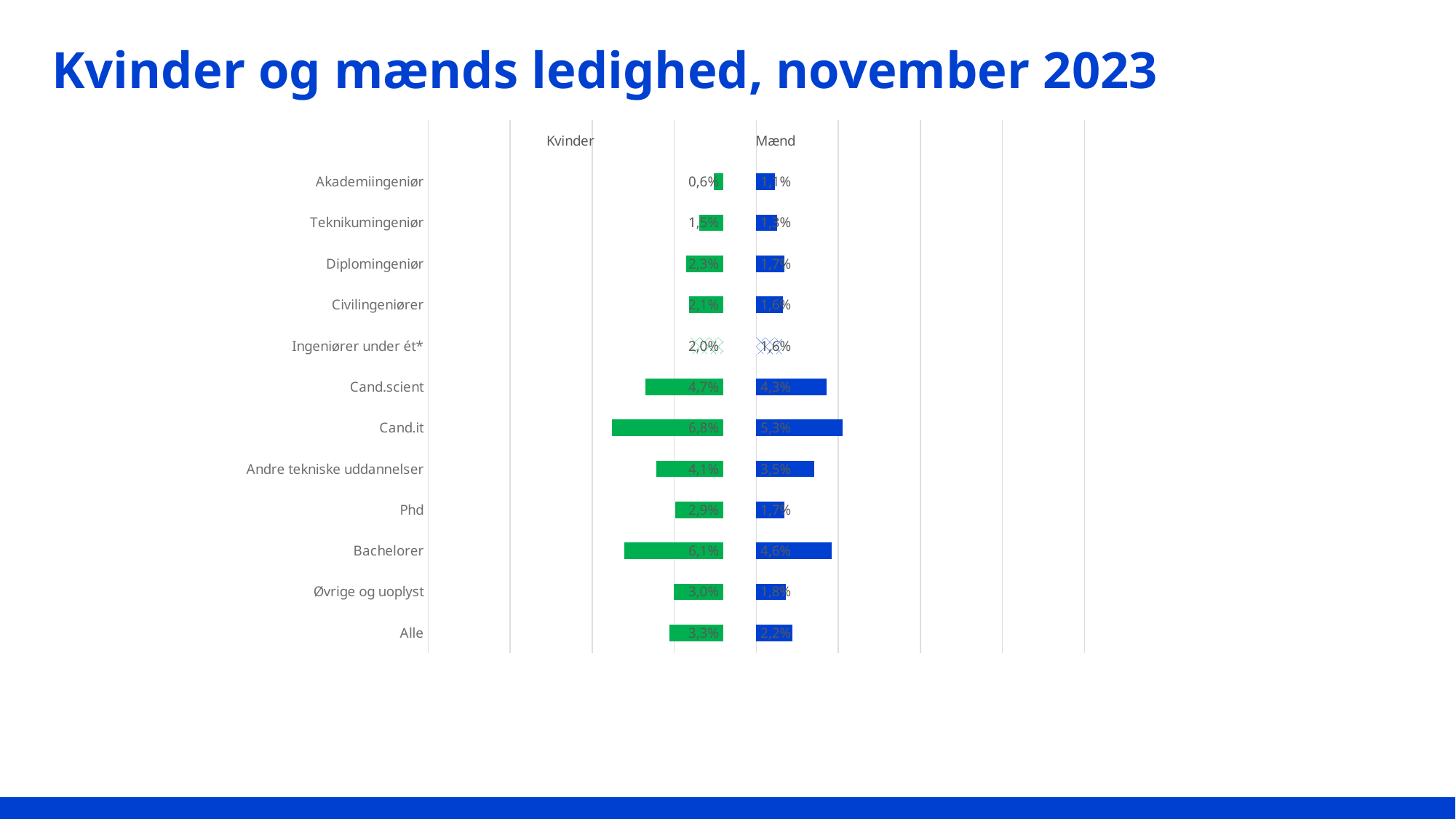
For Bachelorer, which group has the higher unemployment rate, Kvinder or Mænd? Kvinder What is the unemployment rate for Mænd in the Cand.it category? 5,3% Which category has the highest unemployment rate for Kvinder? Cand.it What kind of chart is shown on the slide? Bar chart Which category has the highest unemployment rate for Mænd? Cand.it What is the difference between the Kvinder and Mænd unemployment rates for Cand.it? 1,5 percentage points How many series does the chart show? 2 What is the unemployment rate for Kvinder in the Cand.it category? 6,8% Which category has the lowest unemployment rate for Kvinder? Akademiingeniør What is the unemployment rate for Mænd in the Bachelorer category? 4,6% How many education categories are shown in the chart? 12 What is the unemployment rate for Kvinder in the Alle category? 3,3%